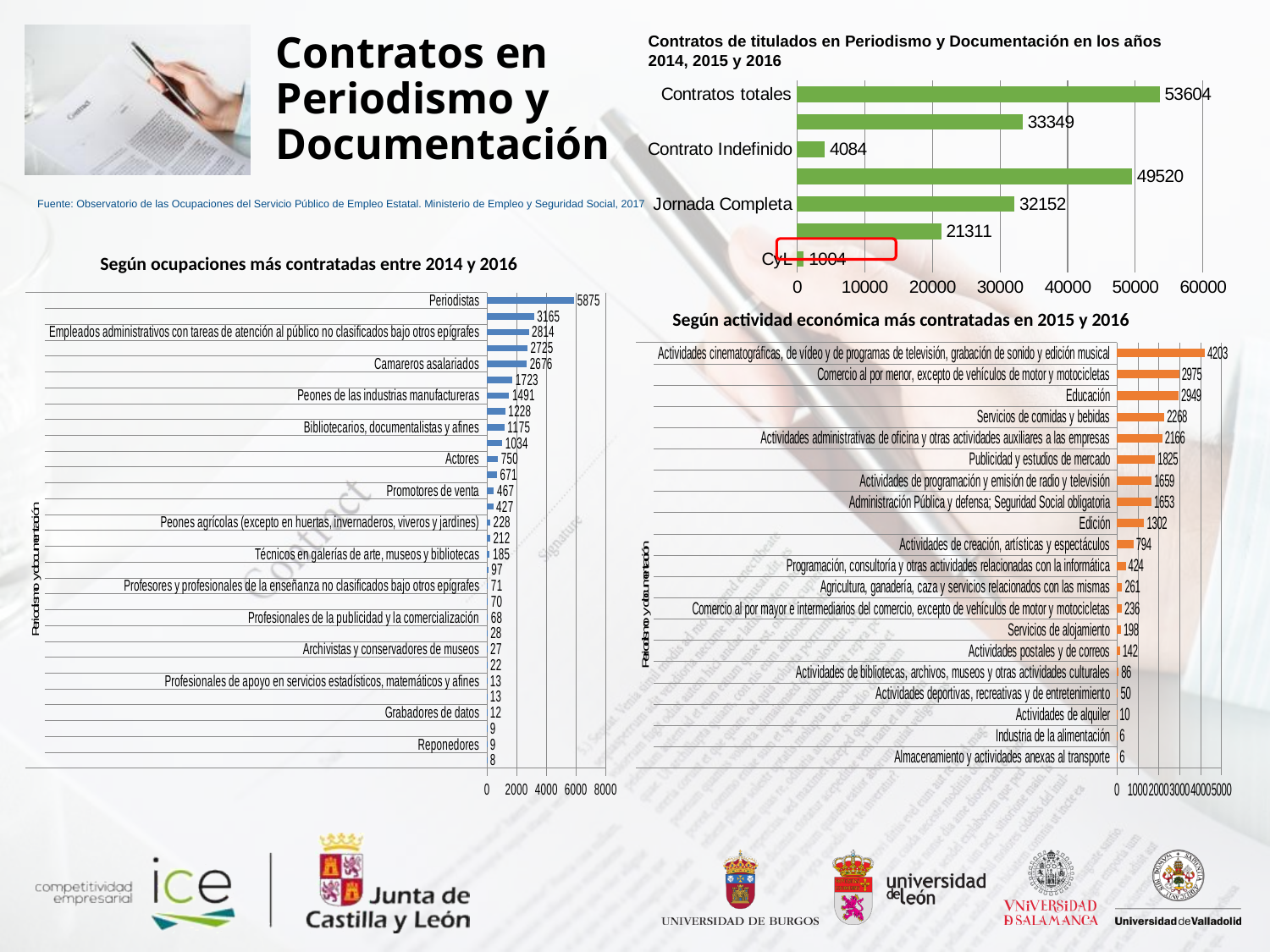
In the chart 'Según ocupaciones más contratadas entre 2014 y 2016', what is the value for Periodistas? 5875 In the chart 'Contratos de titulados en Periodismo y Documentación en los años 2014, 2015 y 2016', what is the value of the first bar for Jornada Completa? 32152 In the chart 'Según actividad económica más contratadas en 2015 y 2016', which activity has the highest value? Actividades cinematográficas, de vídeo y de programas de televisión, grabación de sonido y edición musical In the chart 'Según actividad económica más contratadas en 2015 y 2016', what is the value for Educación? 2949 In the chart 'Según actividad económica más contratadas en 2015 y 2016', how many activities are listed? 20 In the chart 'Contratos de titulados en Periodismo y Documentación en los años 2014, 2015 y 2016', what is the value of the first bar for Contratos totales? 53604 In the chart 'Según actividad económica más contratadas en 2015 y 2016', what is the difference between Comercio al por menor and Edición? 1673 In the chart 'Según ocupaciones más contratadas entre 2014 y 2016', which is larger: Camareros asalariados or Actores? Camareros asalariados In the chart 'Según ocupaciones más contratadas entre 2014 y 2016', what is the difference between Periodistas and Camareros asalariados? 3199 In the chart 'Según actividad económica más contratadas en 2015 y 2016', what is the value for Publicidad y estudios de mercado? 1825 What type of chart is 'Según actividad económica más contratadas en 2015 y 2016'? Bar chart In the chart 'Según ocupaciones más contratadas entre 2014 y 2016', what is the value for Bibliotecarios, documentalistas y afines? 1175